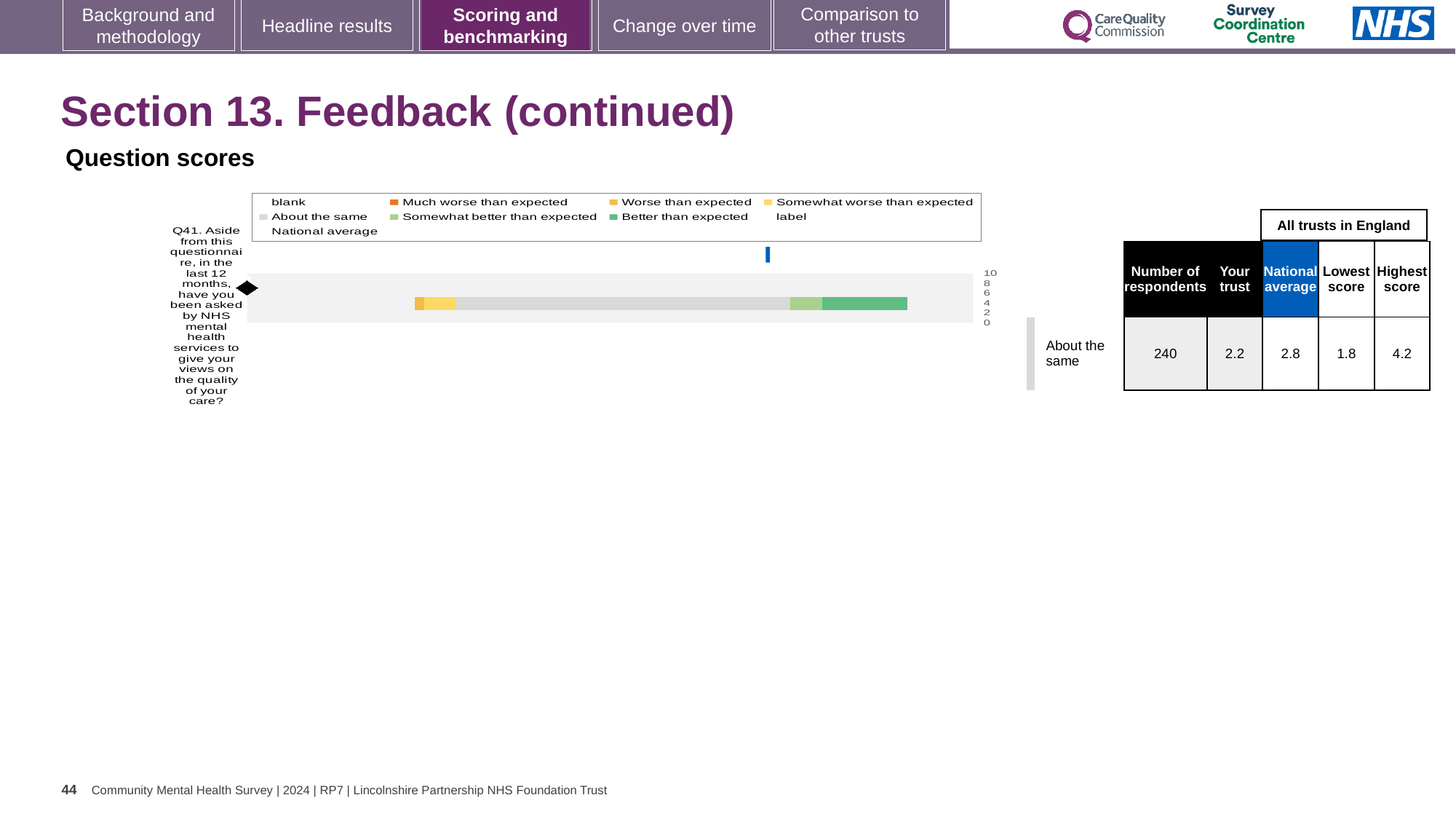
Which question is plotted in the chart? Q41. Aside from this questionnaire, in the last 12 months, have you been asked by NHS mental health services to give your views on the quality of your care? In the table next to the chart, what is the National average score for Q41? 2.8 In the table next to the chart, what is the Lowest score among all trusts in England for Q41? 1.8 What is the difference between the National average and the 'Your trust' score for Q41? 0.6 What kind of chart is shown on the slide for Q41? bar chart What is the difference between the Highest score and the Lowest score for Q41? 2.4 How many questions (categories) are plotted in the chart? 1 Which is larger for Q41, the 'Your trust' score or the National average? National average How many respondents answered Q41 according to the table? 240 Which benchmark category is the trust's Q41 score placed in? About the same In the table next to the chart, what is the Highest score among all trusts in England for Q41? 4.2 In the table next to the chart, what is the 'Your trust' score for Q41? 2.2